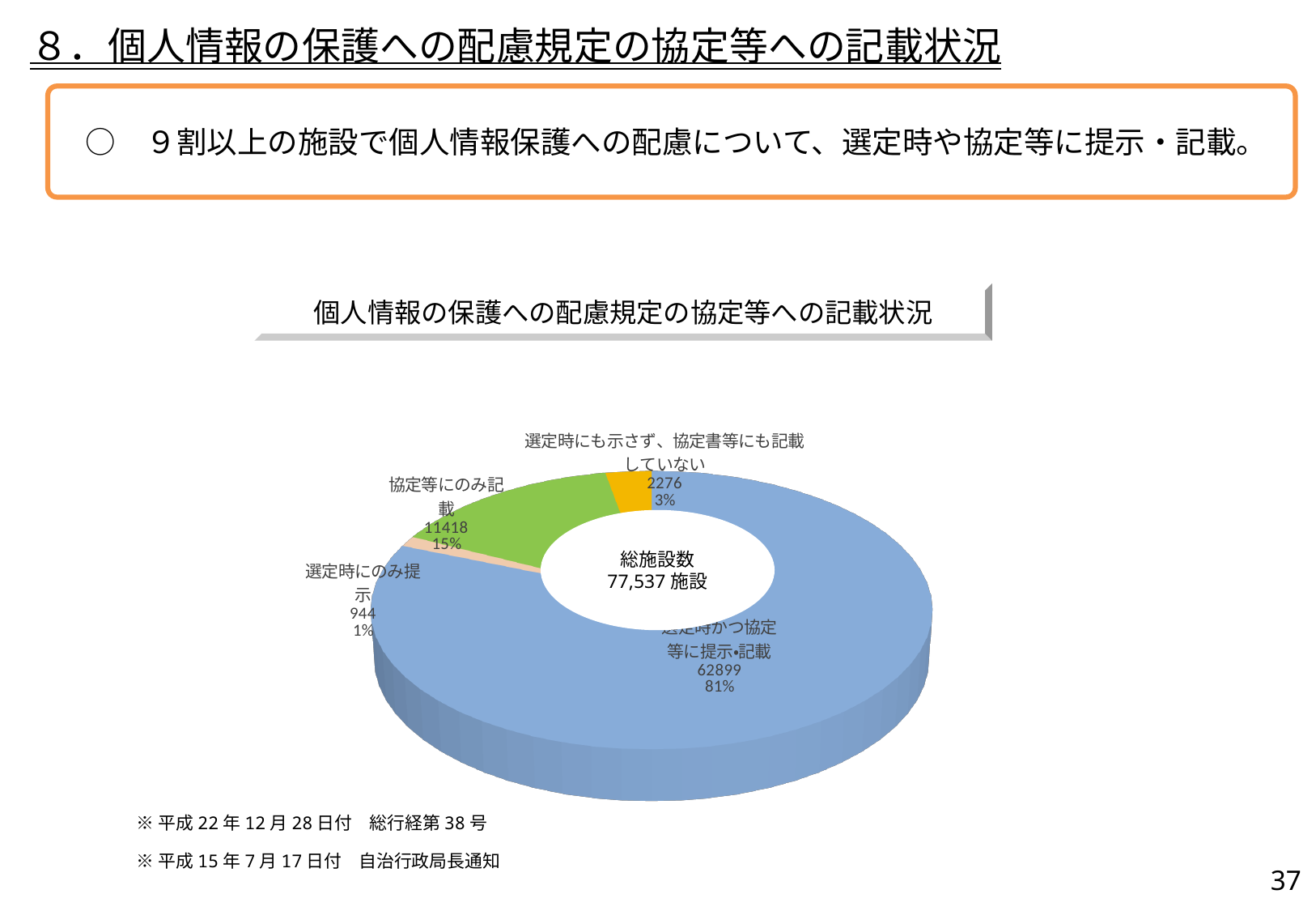
What is the difference between the values for 協定等にのみ記載 and 選定時にも示さず、協定書等にも記載していない? 9142 Which category has the smallest value? 選定時にのみ提示 What total number of facilities is shown in the centre of the chart? 77,537 施設 How many categories does the pie chart show? 4 What is the value for 選定時にのみ提示? 944 What is the value for 協定等にのみ記載? 11418 What kind of chart is shown on the slide? Pie chart (donut) What is the value for 選定時にも示さず、協定書等にも記載していない? 2276 Which category has the largest value? 選定時かつ協定等に提示・記載 What is the value for 選定時かつ協定等に提示・記載? 62899 What share of the pie does 協定等にのみ記載 represent? 15% What share of the pie does 選定時かつ協定等に提示・記載 represent? 81%